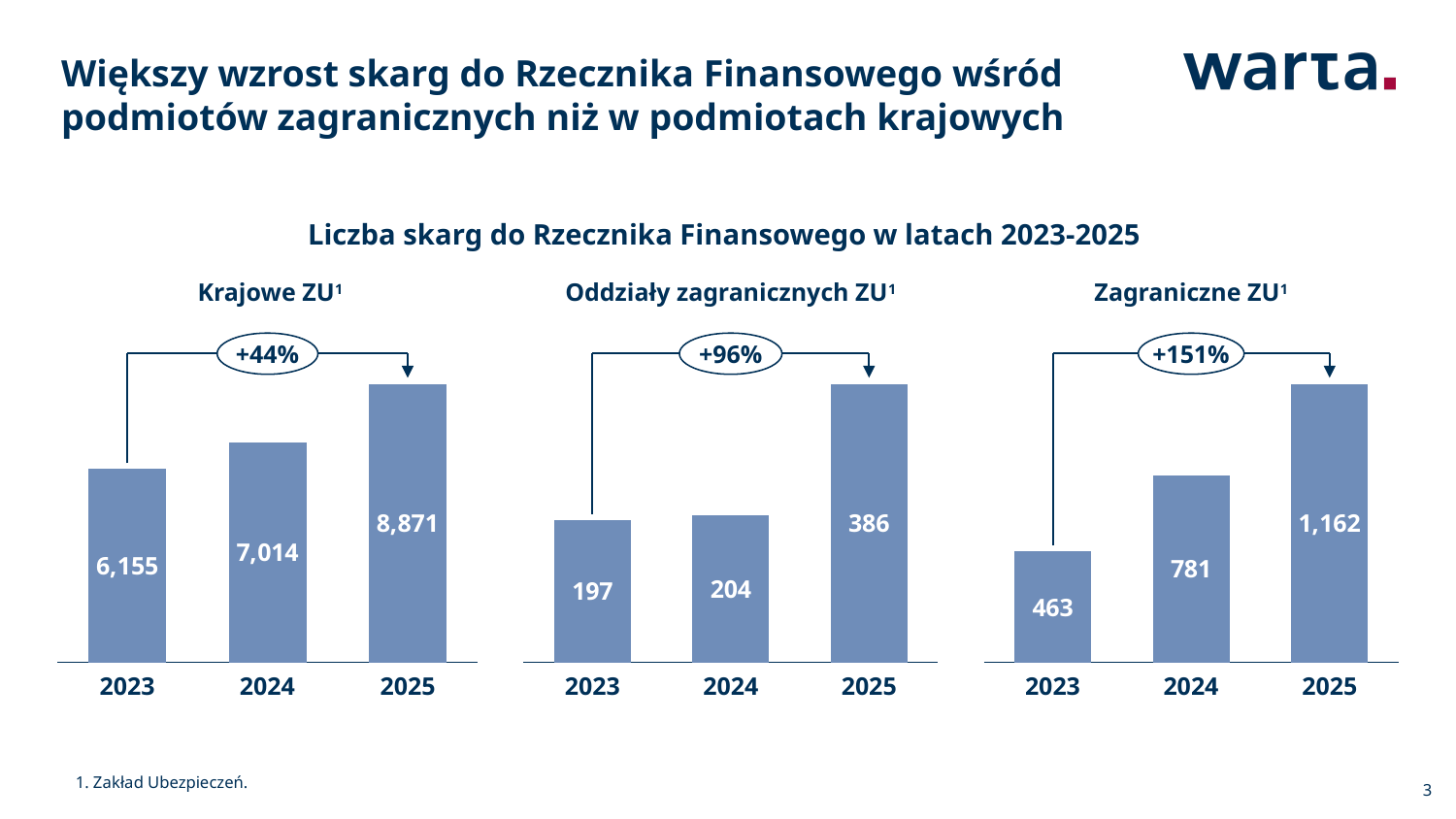
In the 'Zagraniczne ZU' chart, is the value for 2024 larger or smaller than the value for 2025? smaller What percentage change is shown above the 'Oddziały zagranicznych ZU' chart? +96% In the 'Zagraniczne ZU' chart, what is the value for 2024? 781 In the 'Oddziały zagranicznych ZU' chart, what is the difference between the 2025 and 2024 values? 182 In the 'Krajowe ZU' chart, what is the value for 2025? 8,871 What kind of chart is the 'Krajowe ZU' chart? bar chart How many bars are in the 'Oddziały zagranicznych ZU' chart? 3 In the 'Zagraniczne ZU' chart, do the values rise or fall from 2023 to 2025? rise In the 'Krajowe ZU' chart, which year has the lowest value? 2023 In the 'Oddziały zagranicznych ZU' chart, what is the value for 2023? 197 In the 'Krajowe ZU' chart, what is the difference between the 2025 and 2023 values? 2,716 In the 'Zagraniczne ZU' chart, which year has the highest value? 2025